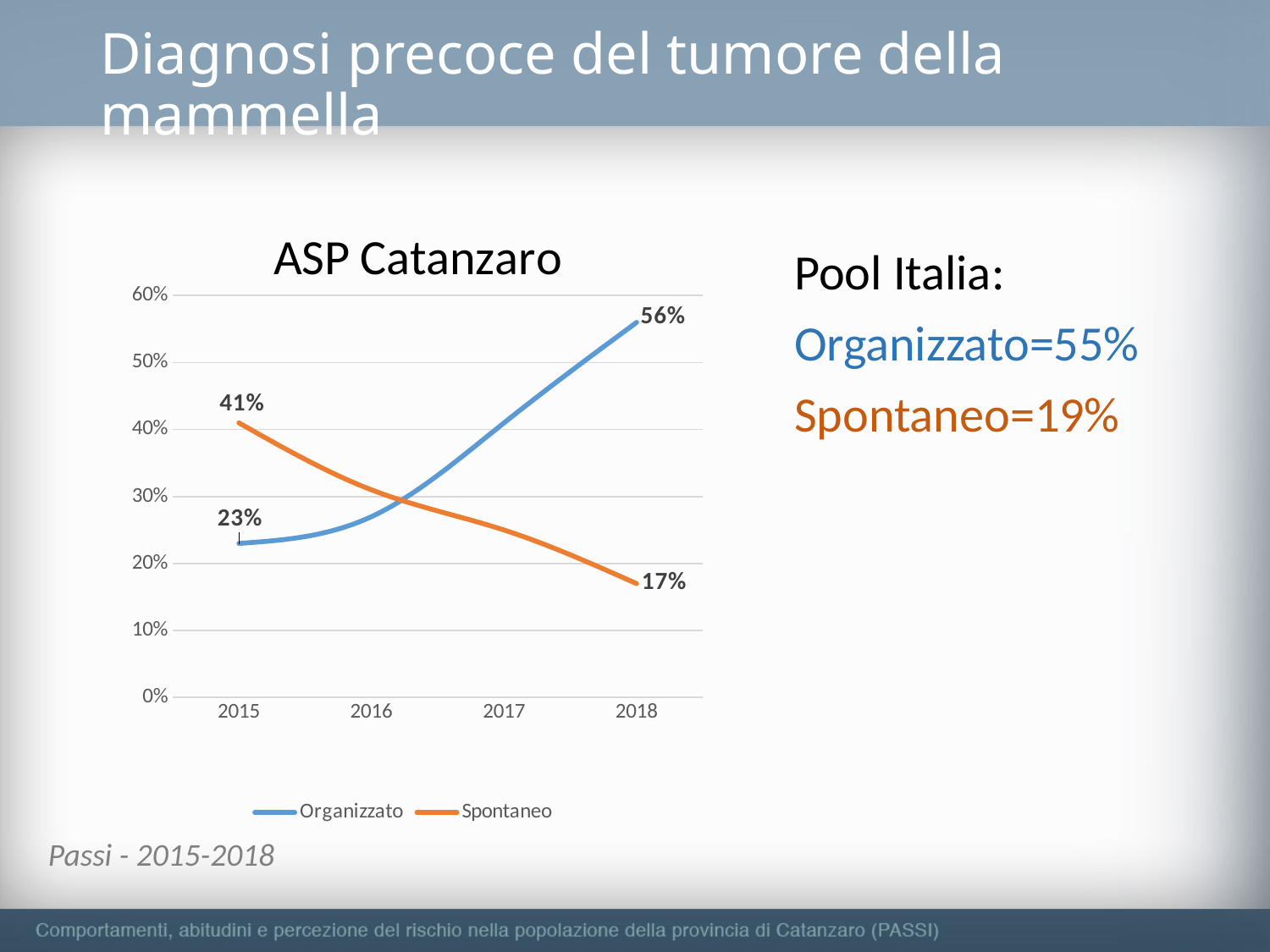
What is the value of the Spontaneo series in 2018? 17% What is the value of the Organizzato series in 2018? 56% What is the value of the Spontaneo series in 2015? 41% By how many percentage points did the Organizzato series change from 2015 to 2018? 33 percentage points Is the value of the Organizzato series in 2017 greater or less than 30%? greater What is the difference between the Organizzato and Spontaneo values in 2018? 39 percentage points Is the value of the Spontaneo series in 2017 greater or less than 30%? less Does the Spontaneo series rise or fall from 2015 to 2018? fall What is the value of the Organizzato series in 2015? 23% In 2015, which series has the higher value, Organizzato or Spontaneo? Spontaneo What type of chart is shown? line chart How many series does the legend list? 2